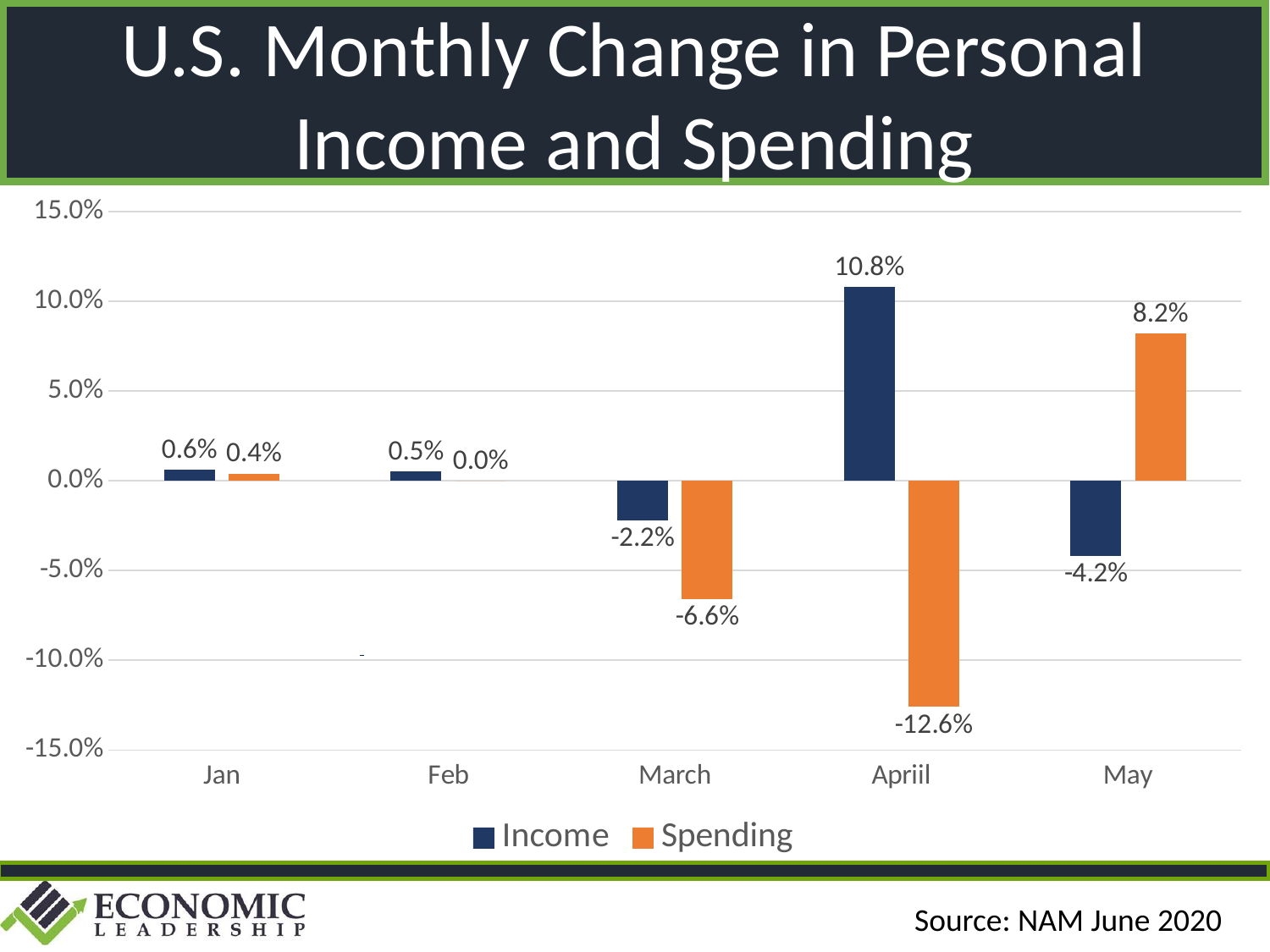
What is the Income value for Feb? 0.5% What is the Income value for April? 10.8% Which month has the lowest Spending value? April What kind of chart is shown on the slide? Bar chart Which is larger in May, the Income value or the Spending value? Spending What is the source cited at the bottom of the slide? NAM June 2020 How many series does the legend list? 2 How many months are shown on the x axis? 5 What is the Spending value for May? 8.2% Which month has the highest Income value? April What is the Spending value for March? -6.6% What is the difference between the Income and Spending values for April? 23.4 percentage points